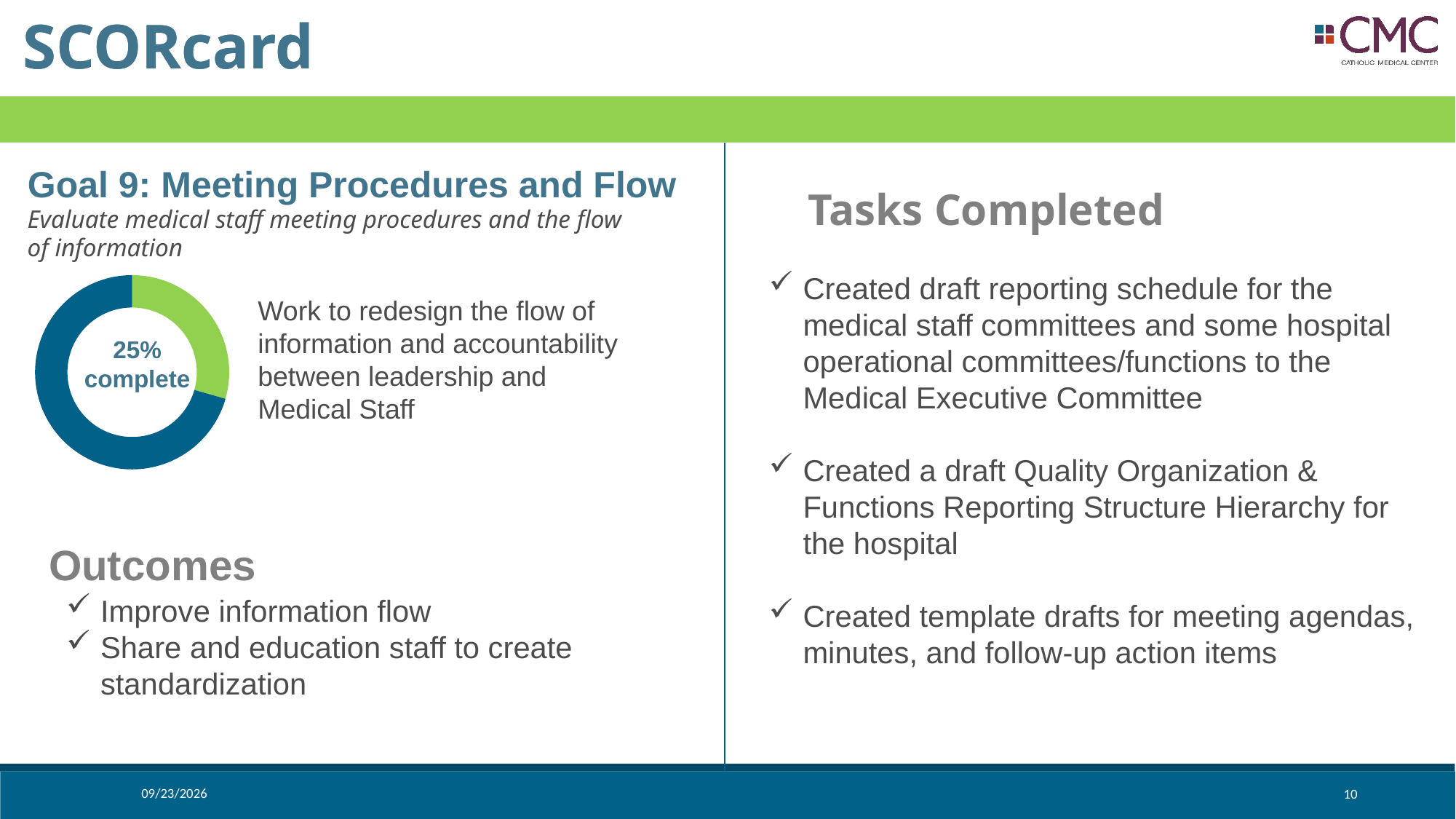
What percentage complete does the donut chart show for Goal 9? 25% complete How many segments does the donut chart have? 2 Which segment of the donut chart is larger, the green one or the dark blue one? The dark blue one What text is printed in the centre of the donut chart? 25% complete What kind of chart is shown on the slide? Donut chart Is the completed share shown in the donut chart greater or less than 50%? less What colour is the completed portion of the donut chart? Green